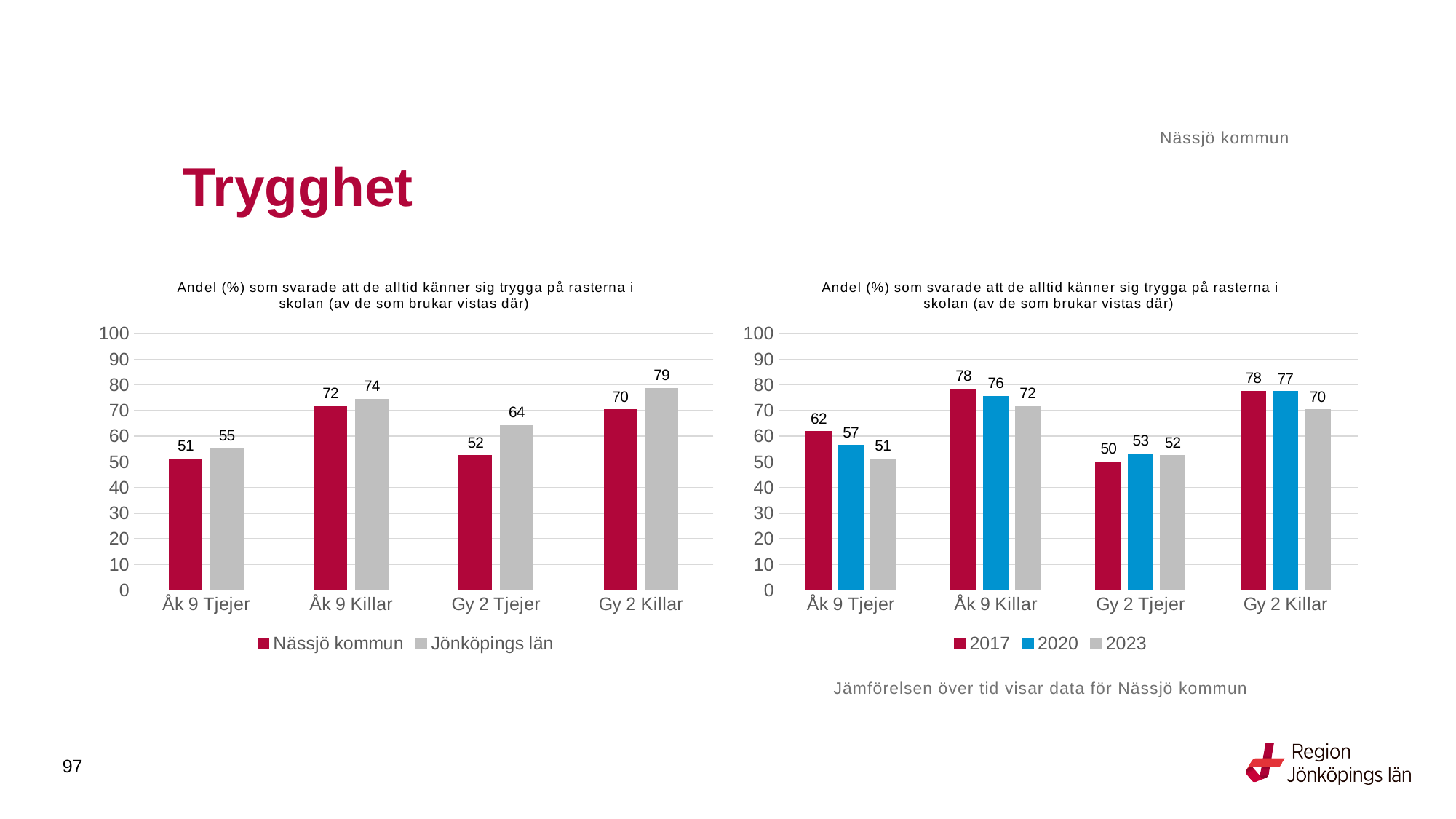
In the right chart, how many categories are shown on the x axis? 4 In the left chart, which category has the lowest value for Nässjö kommun? Åk 9 Tjejer In the right chart, what is the value for 2020 for Åk 9 Tjejer? 57 In the left chart, what is the value for Nässjö kommun for Åk 9 Killar? 72 In the left chart, what is the value for Jönköpings län for Gy 2 Tjejer? 64 What type of chart is the right chart? Bar chart In the left chart, which category has the highest value for Jönköpings län? Gy 2 Killar In the left chart, what is the difference between Jönköpings län and Nässjö kommun for Gy 2 Killar? 9 In the right chart, what is the value for 2023 for Gy 2 Killar? 70 In the right chart, which is larger for Gy 2 Tjejer: 2017 or 2020? 2020 In the right chart, what is the difference between the 2017 and 2023 values for Åk 9 Tjejer? 11 In the left chart, how many series does the legend list? 2